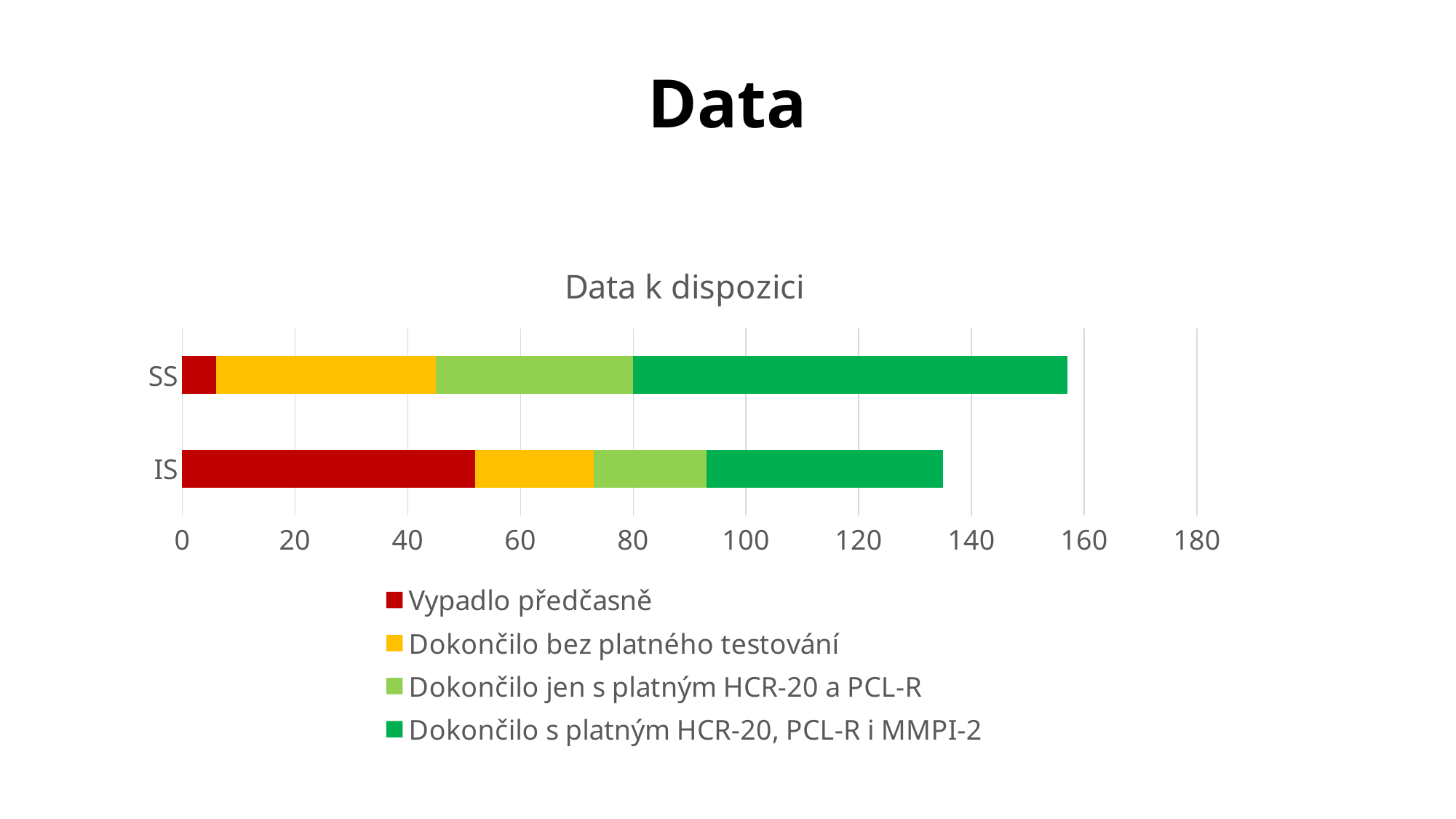
What kind of chart is shown on the slide? bar chart Which category has the larger 'Dokončilo s platným HCR-20, PCL-R i MMPI-2' segment, SS or IS? SS How many categories are plotted on the vertical axis? 2 Which category has the longer total bar, SS or IS? SS Is the 'Vypadlo předčasně' value for IS greater or less than 40? greater What colour represents 'Vypadlo předčasně' in the legend? red What is the title of the chart? Data k dispozici Is the total of the IS bar greater or less than 140? less Is the 'Vypadlo předčasně' value for SS greater or less than 20? less How many series does the legend list? 4 Which category has the larger 'Vypadlo předčasně' segment, SS or IS? IS